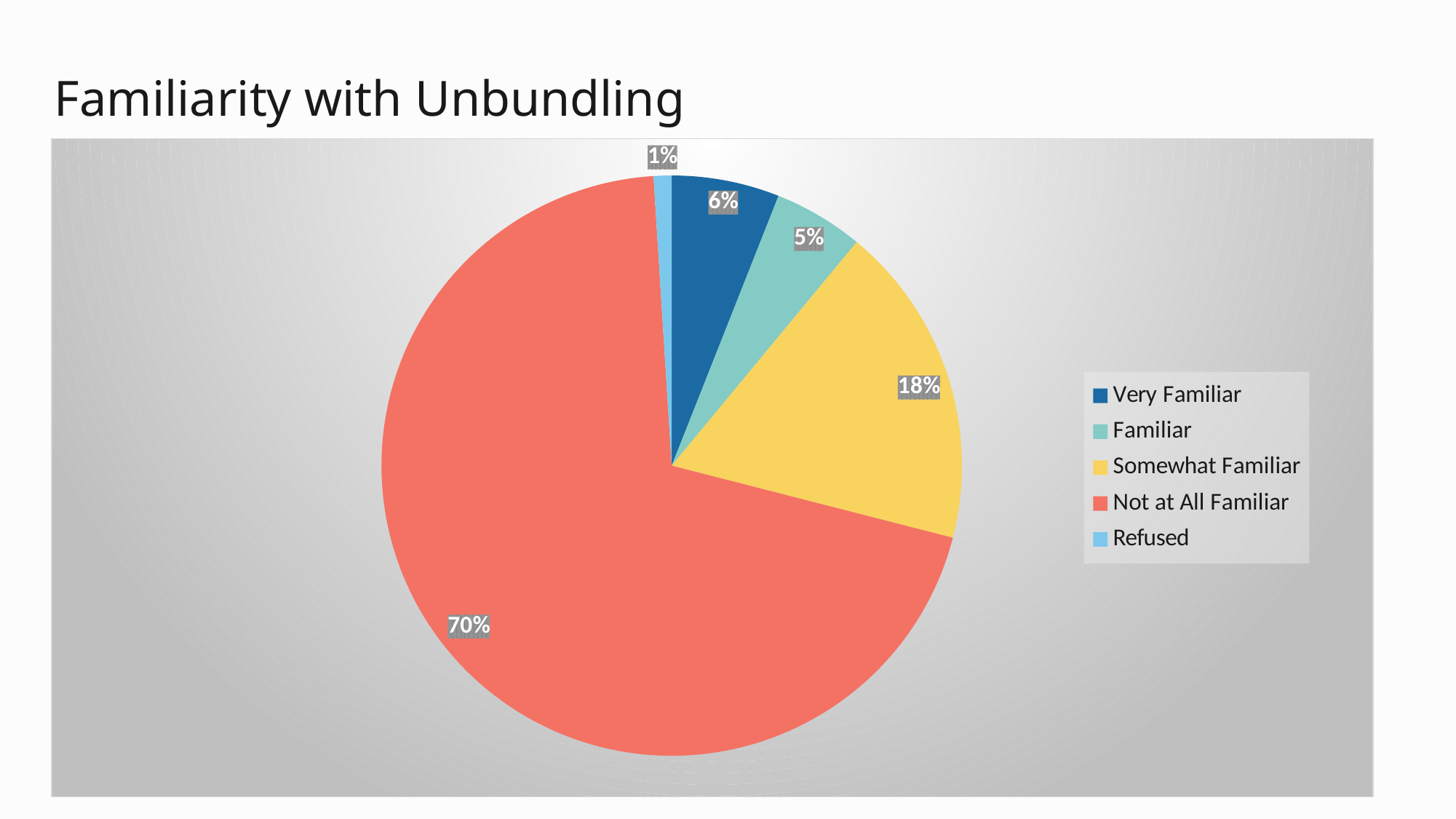
What is the value for Familiar? 5% Which category has the largest slice of the pie? Not at All Familiar What is the title of the slide containing the chart? Familiarity with Unbundling What share of the pie is labelled Not at All Familiar? 70% What is the value for Very Familiar? 6% What is the difference between the Not at All Familiar and Somewhat Familiar shares? 52% What is the value for Refused? 1% Which is larger, the Very Familiar slice or the Familiar slice? Very Familiar What share of the pie is labelled Somewhat Familiar? 18% What kind of chart is shown on the slide? pie chart How many categories does the pie chart have? 5 Which category has the smallest slice of the pie? Refused